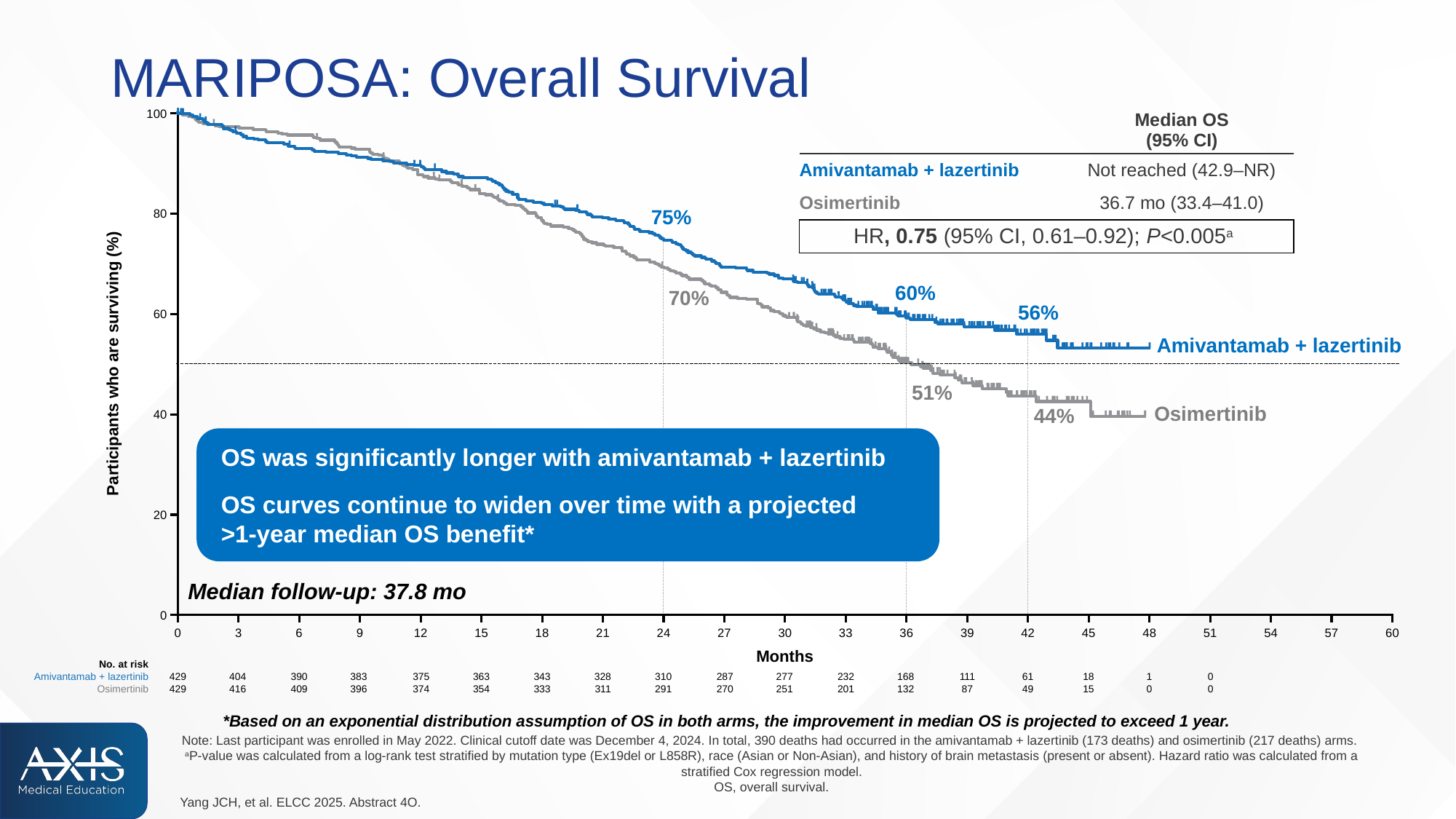
Do the survival curves rise or fall as months increase? Fall What is the hazard ratio shown on the chart? 0.75 What is the difference in overall survival rate between amivantamab + lazertinib and osimertinib at 36 months? 9 percentage points Which arm has the higher overall survival rate at 42 months? Amivantamab + lazertinib How many treatment arms are plotted on the chart? 2 What is the overall survival rate for amivantamab + lazertinib at 24 months? 75% What is the median OS for the osimertinib arm? 36.7 mo (33.4–41.0) What is the overall survival rate for osimertinib at 24 months? 70% What is the overall survival rate for amivantamab + lazertinib at 36 months? 60% What is the overall survival rate for osimertinib at 42 months? 44% How many participants were at risk in the osimertinib arm at 24 months? 291 What kind of chart is shown on the slide? Line chart (Kaplan-Meier survival curve)